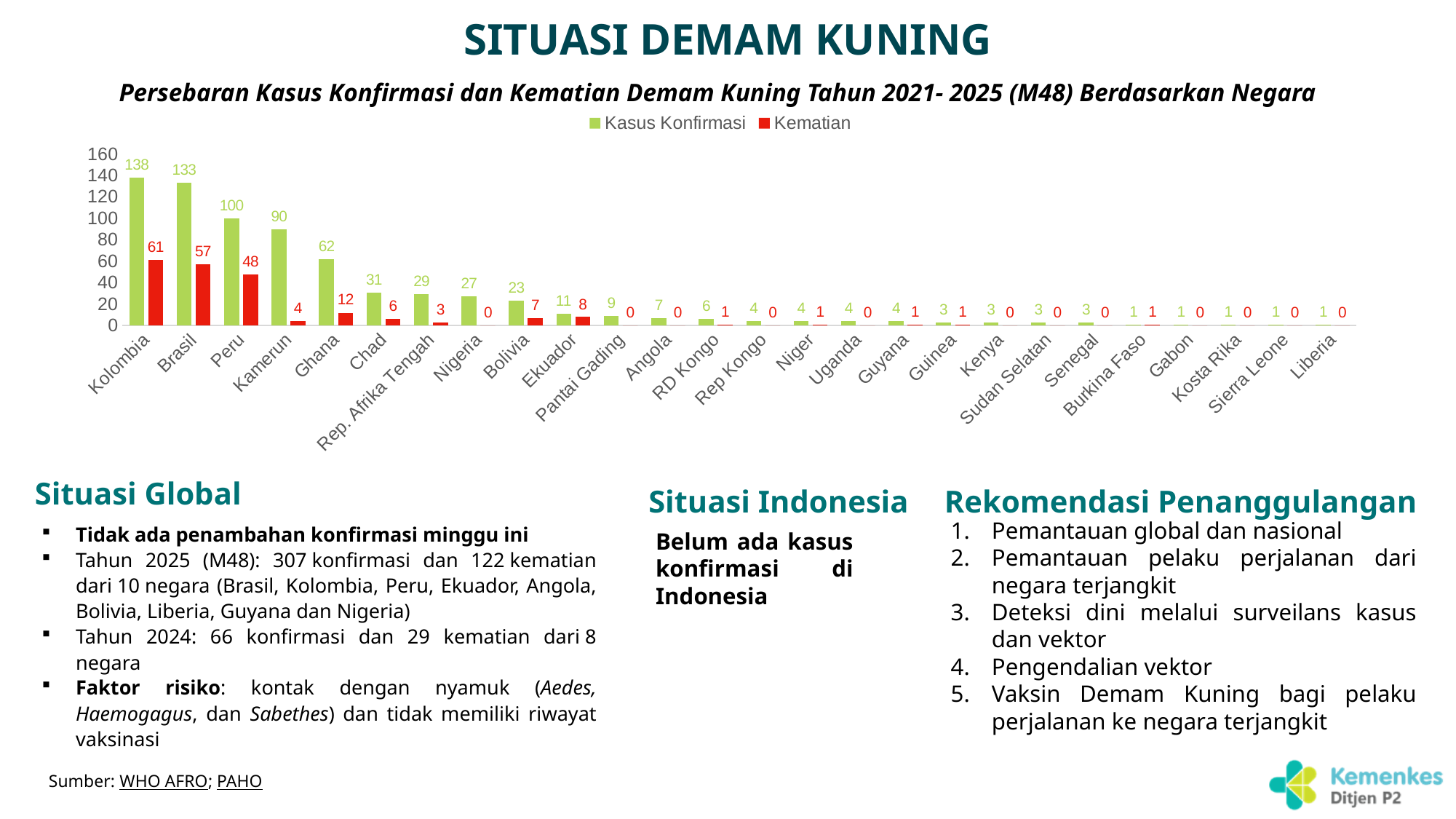
Which is larger, the Kematian for Ghana or the Kematian for Kamerun? Ghana What is the number of Kasus Konfirmasi for Kolombia? 138 Which country has the highest number of Kematian? Kolombia What is the number of Kasus Konfirmasi for Ghana? 62 What type of chart is shown on the slide? Bar chart Is the value of Kasus Konfirmasi for Kamerun greater or less than 80? greater How many series does the chart legend list? 2 What is the number of Kematian for Peru? 48 How many countries are shown on the x axis of the chart? 26 What is the difference between Kematian for Kolombia and Brasil? 4 Which country has the highest number of Kasus Konfirmasi? Kolombia What is the difference between Kasus Konfirmasi for Brasil and Peru? 33